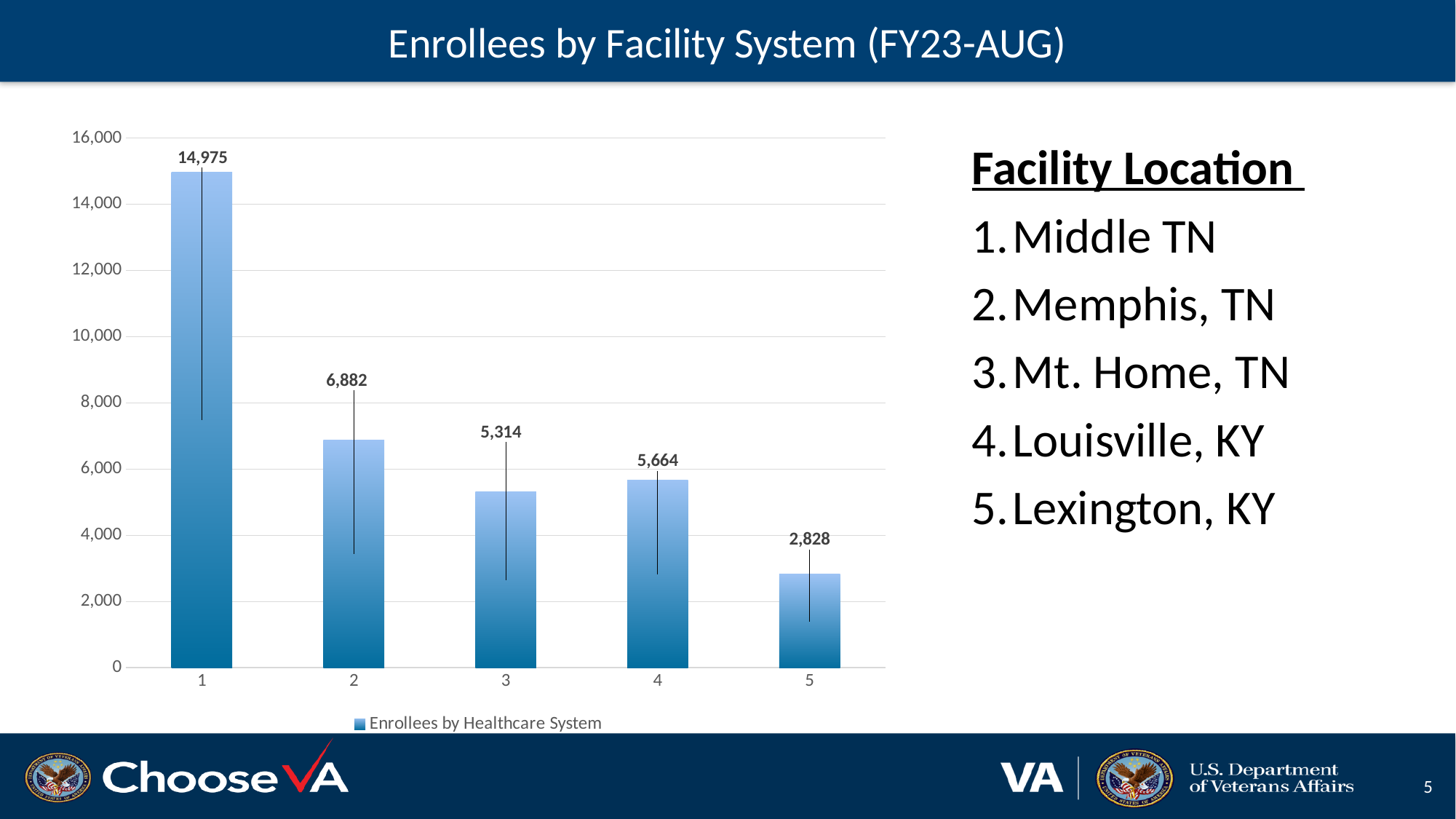
What is the difference between the values for category 1 and category 2? 8,093 What is the value of the bar for category 1 (Middle TN)? 14,975 What kind of chart is shown on the slide? Bar chart What series name does the legend show? Enrollees by Healthcare System Which category has the highest number of enrollees? 1 (Middle TN) Which category has the lowest number of enrollees? 5 (Lexington, KY) Is the value for category 2 greater or less than 6,000? greater What is the value of the bar for category 2 (Memphis, TN)? 6,882 How many categories (bars) are shown in the chart? 5 What is the difference between the values for category 4 and category 3? 350 What is the value of the bar for category 5 (Lexington, KY)? 2,828 Which is larger, the value for category 3 or the value for category 4? Category 4